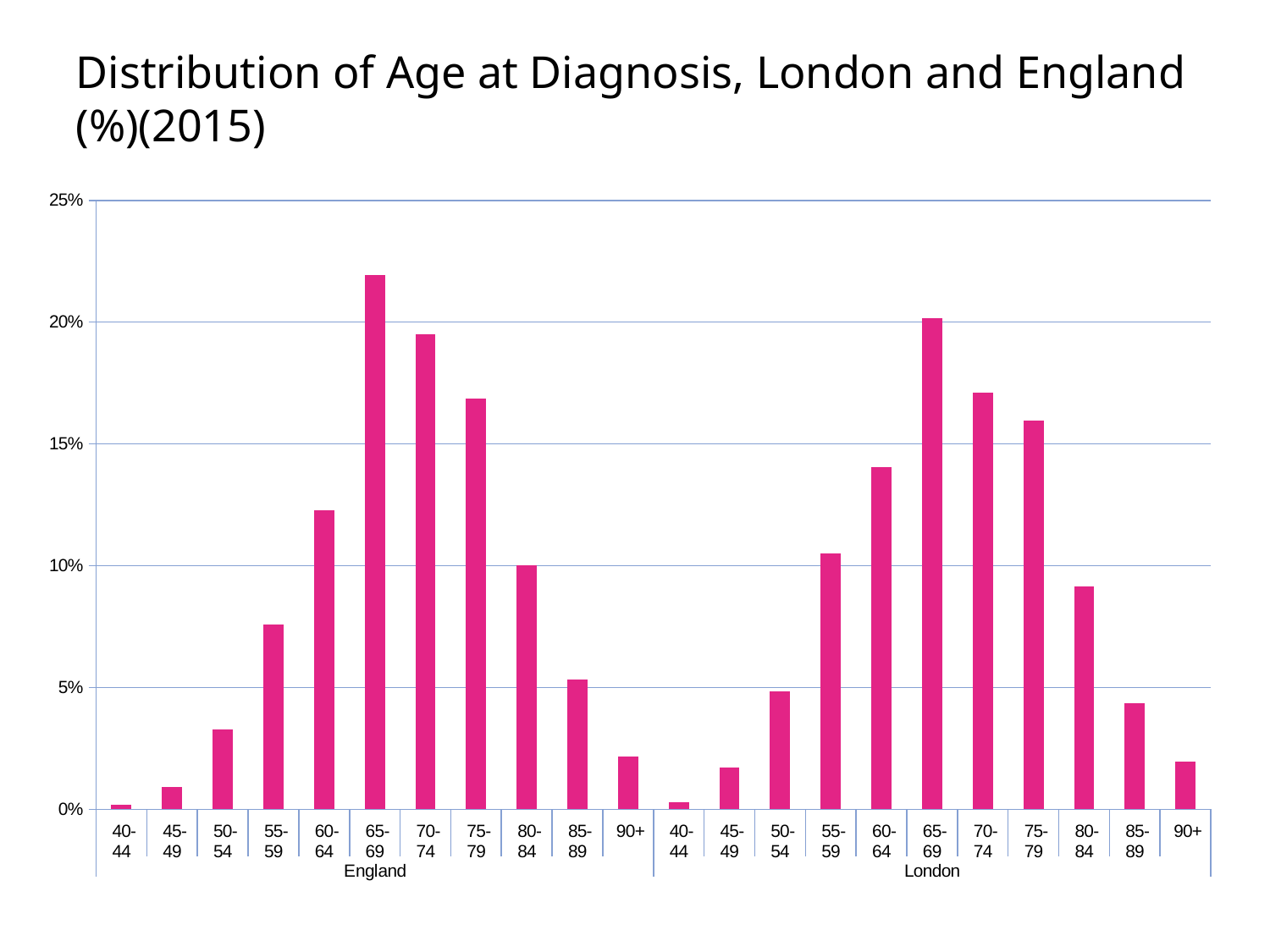
Which age group has the lowest value for England? 40-44 Is the value for England 65-69 greater or less than 20%? greater Is the value for London 55-59 greater or less than 10%? greater Which is larger, the value for England 65-69 or London 65-69? England 65-69 How many age groups are shown for each region? 11 Which is larger, the value for England 55-59 or London 55-59? London 55-59 Which age group has the highest value for London? 65-69 Which age group has the highest value for England? 65-69 Is the value for England 60-64 greater or less than 10%? greater What kind of chart is shown on the slide? bar chart Do the values for England rise or fall from the 65-69 age group to the 90+ age group? fall